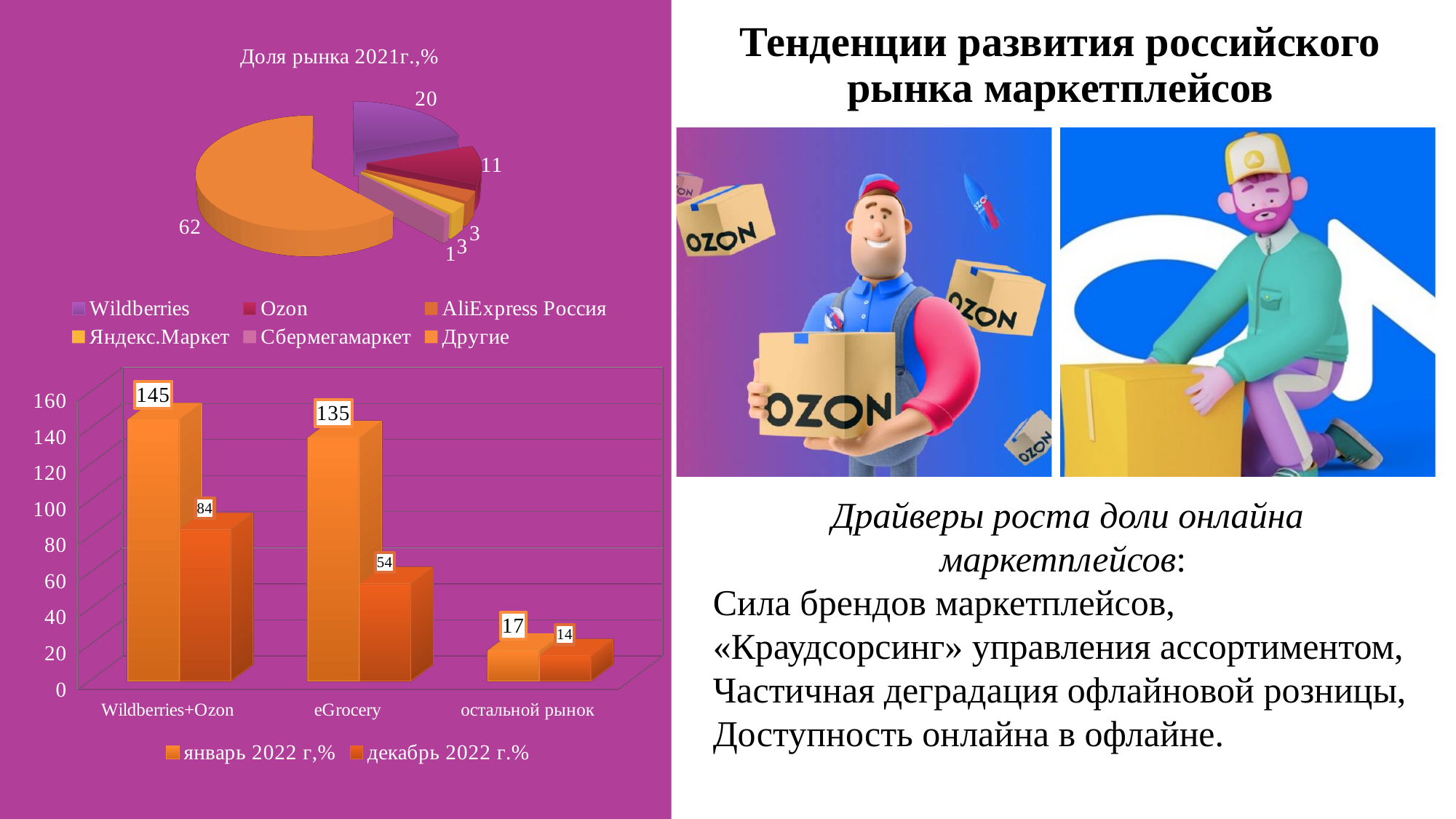
In the bar chart at the bottom left, what is the value for Wildberries+Ozon in the series 'январь 2022 г,%'? 145 In the pie chart 'Доля рынка 2021г.,%', what is the value for Wildberries? 20 In the bar chart at the bottom left, what is the difference between the January and December 2022 values for Wildberries+Ozon? 61 In the pie chart 'Доля рынка 2021г.,%', which category has the largest slice? Другие In the pie chart 'Доля рынка 2021г.,%', what is the value for Ozon? 11 In the bar chart at the bottom left, how many series does the legend list? 2 In the bar chart at the bottom left, which category has the lowest value in the series 'январь 2022 г,%'? остальной рынок In the pie chart 'Доля рынка 2021г.,%', which category has the smallest slice? Сбермегамаркет In the pie chart 'Доля рынка 2021г.,%', how many categories does the legend list? 6 In the bar chart at the bottom left, what is the value for eGrocery in the series 'декабрь 2022 г.%'? 54 In the pie chart 'Доля рынка 2021г.,%', what is the difference between the values for Wildberries and Ozon? 9 What type of chart is shown at the bottom left of the slide? bar chart